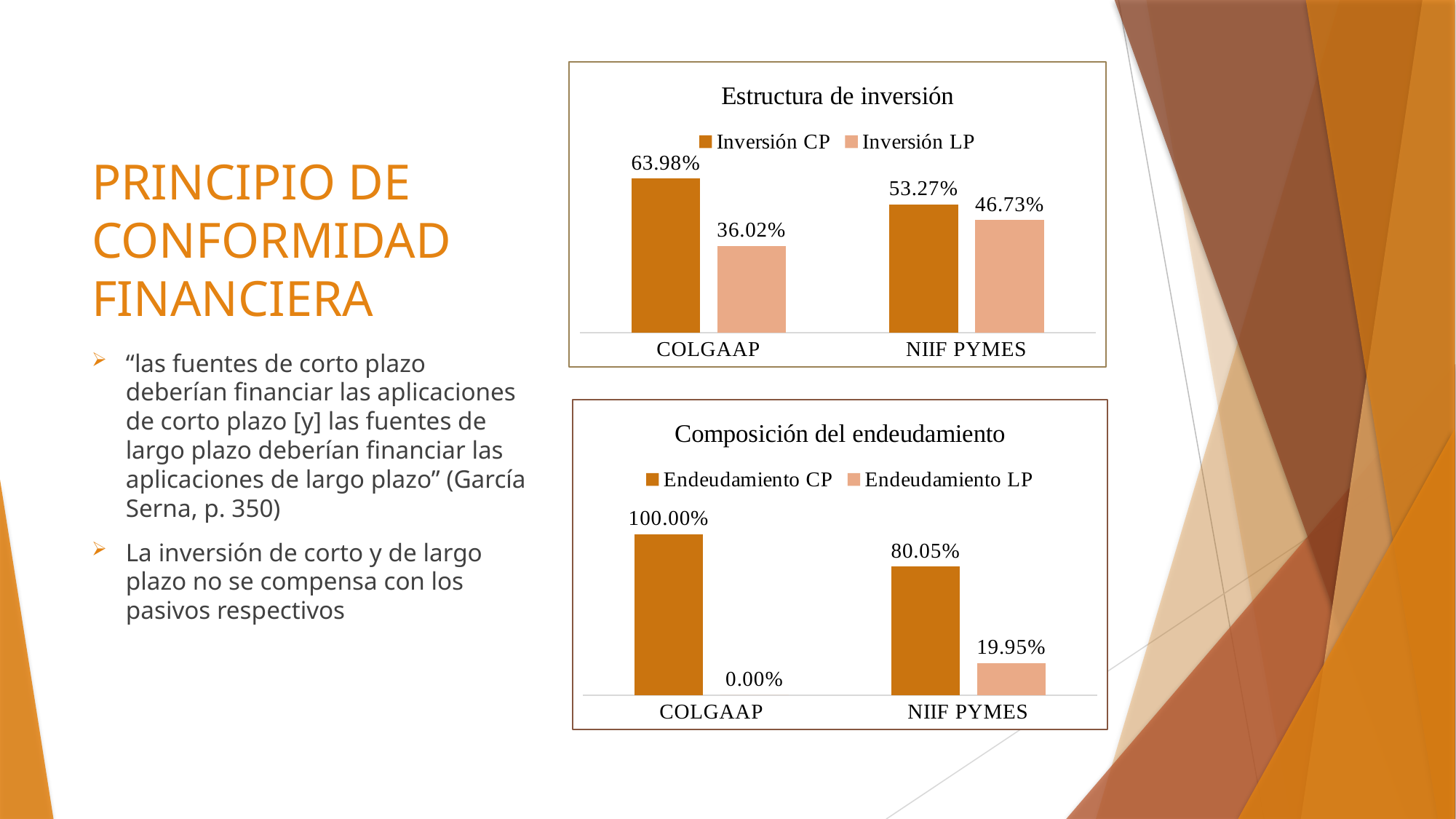
In the 'Composición del endeudamiento' chart, what is the value of Endeudamiento CP for COLGAAP? 100.00% In the 'Estructura de inversión' chart, which is larger for NIIF PYMES: Inversión CP or Inversión LP? Inversión CP In the 'Composición del endeudamiento' chart, what is the value of Endeudamiento LP for COLGAAP? 0.00% What kind of chart is the 'Composición del endeudamiento' chart? Bar chart In the 'Estructura de inversión' chart, what is the value of Inversión LP for NIIF PYMES? 46.73% In the 'Composición del endeudamiento' chart, what is the value of Endeudamiento LP for NIIF PYMES? 19.95% In the 'Composición del endeudamiento' chart, which bar is the lowest? Endeudamiento LP for COLGAAP In the 'Estructura de inversión' chart, what is the difference between Inversión CP and Inversión LP for COLGAAP? 27.96% How many categories are shown on the x axis of the 'Estructura de inversión' chart? 2 In the 'Composición del endeudamiento' chart, what is the difference between Endeudamiento CP and Endeudamiento LP for NIIF PYMES? 60.10% In the 'Estructura de inversión' chart, how many series does the legend list? 2 In the 'Estructura de inversión' chart, what is the value of Inversión CP for COLGAAP? 63.98%